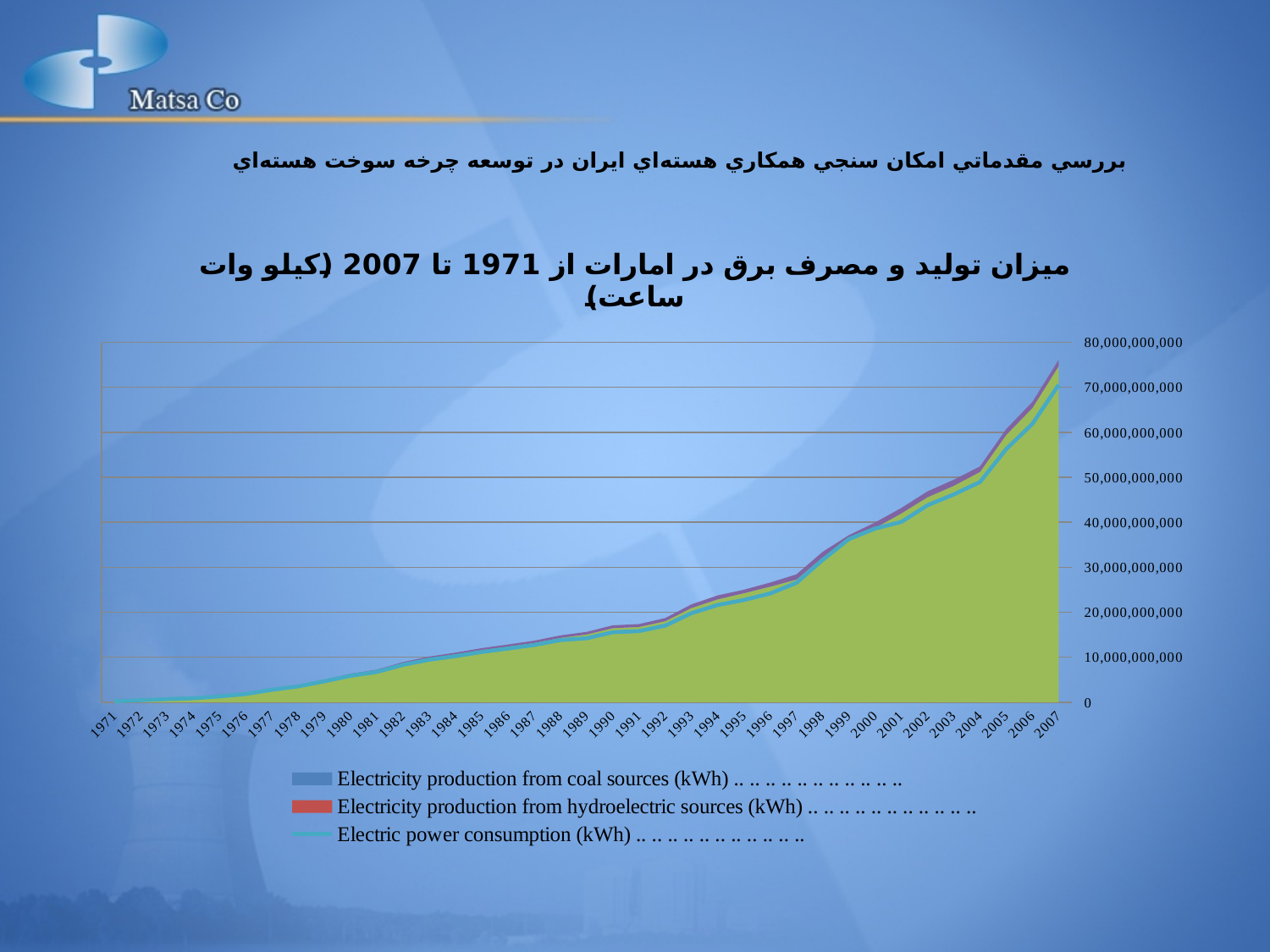
Do the plotted values rise or fall from 1971 to 2007? rise In which year is the plotted value highest? 2007 Which is larger, the value for 2005 or the value for 1995? 2005 Is the value for 1990 greater or less than 20,000,000,000? less Is the value for 2000 greater or less than 30,000,000,000? greater What kind of chart is shown on the slide? area chart In which year is the plotted value lowest? 1971 Is the value for 1997 greater or less than 30,000,000,000? less How many series does the legend list? 3 What is the first year shown on the x axis? 1971 How many years are plotted along the x axis? 37